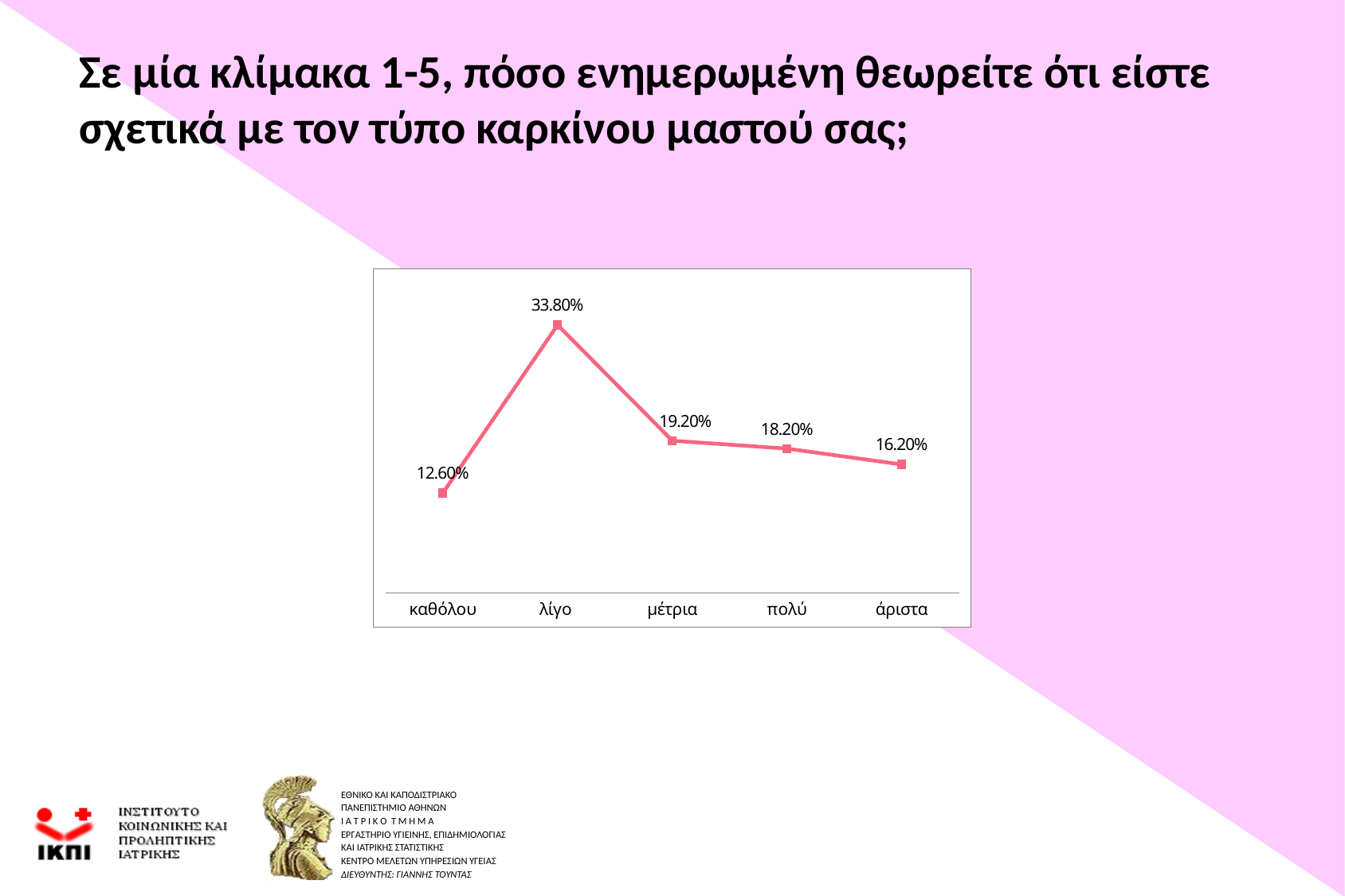
Which category has the lowest value? καθόλου Which is larger, the value for μέτρια or the value for άριστα? μέτρια What is the difference between the values for λίγο and μέτρια? 14.60% What is the difference between the values for άριστα and καθόλου? 3.60% What is the value for λίγο? 33.80% Which category has the highest value? λίγο How many categories are shown on the x axis? 5 What is the value for πολύ? 18.20% What is the value for άριστα? 16.20% What is the value for καθόλου? 12.60% What kind of chart is shown on the slide? line chart Do the values rise or fall from μέτρια to άριστα? fall